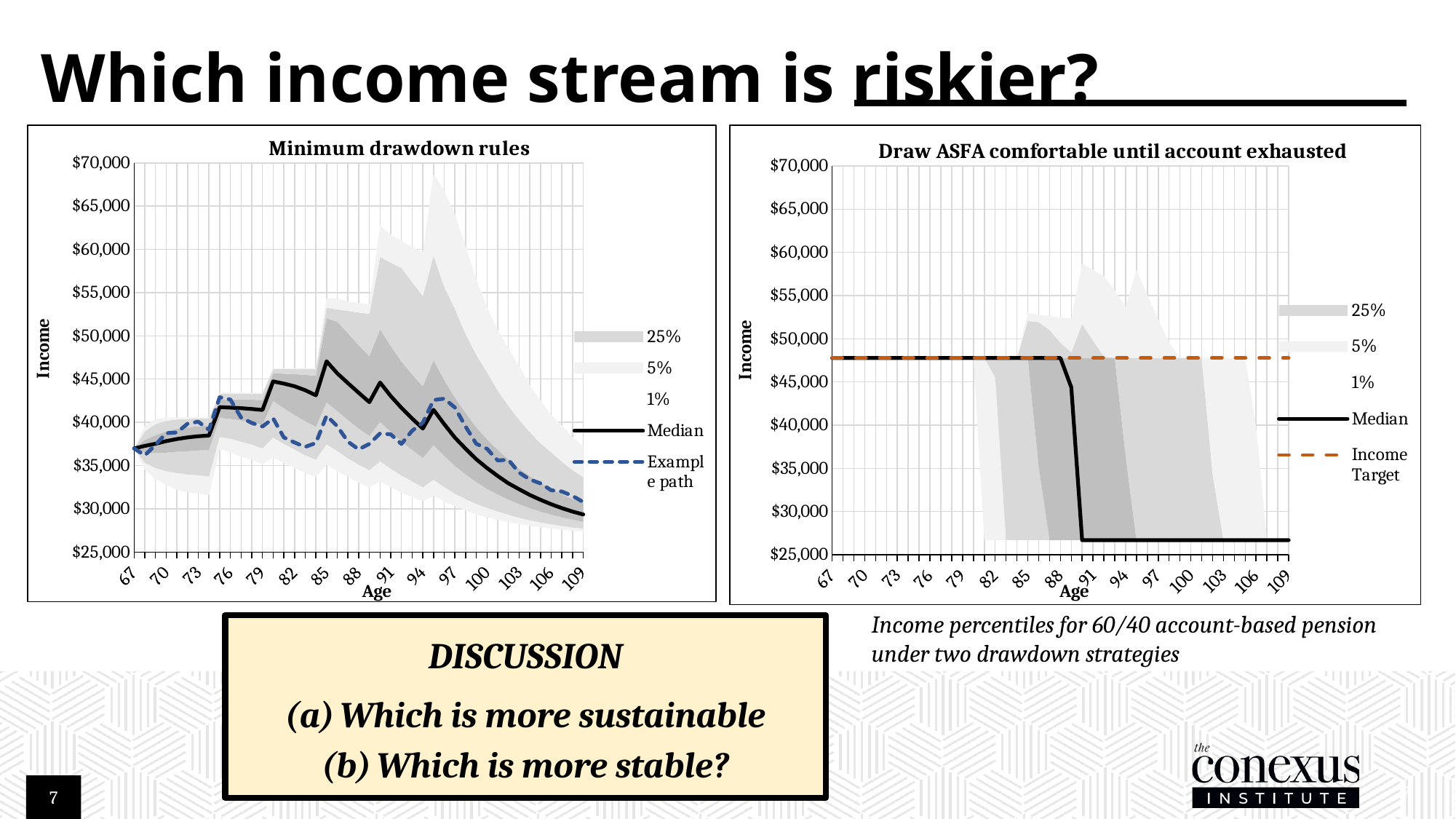
In the right chart (Draw ASFA comfortable until account exhausted), is the Median value at age 100 greater or less than $30,000? less What is the title of the left chart? Minimum drawdown rules In the left chart (Minimum drawdown rules), how many entries does the legend list? 5 In the right chart (Draw ASFA comfortable until account exhausted), does the Median line rise or fall overall from age 67 to age 109? fall In the left chart (Minimum drawdown rules), is the Median value at age 109 higher or lower than at age 67? lower How many age labels are shown on the x axis of the right chart (Draw ASFA comfortable until account exhausted)? 15 In the left chart (Minimum drawdown rules), is the Median value at age 85 greater or less than $45,000? greater What kind of chart is the left chart (Minimum drawdown rules)? combination area and line chart In the left chart (Minimum drawdown rules), is the Median value at age 109 greater or less than $30,000? less In the right chart (Draw ASFA comfortable until account exhausted), how many entries does the legend list? 5 What is the title of the right chart? Draw ASFA comfortable until account exhausted